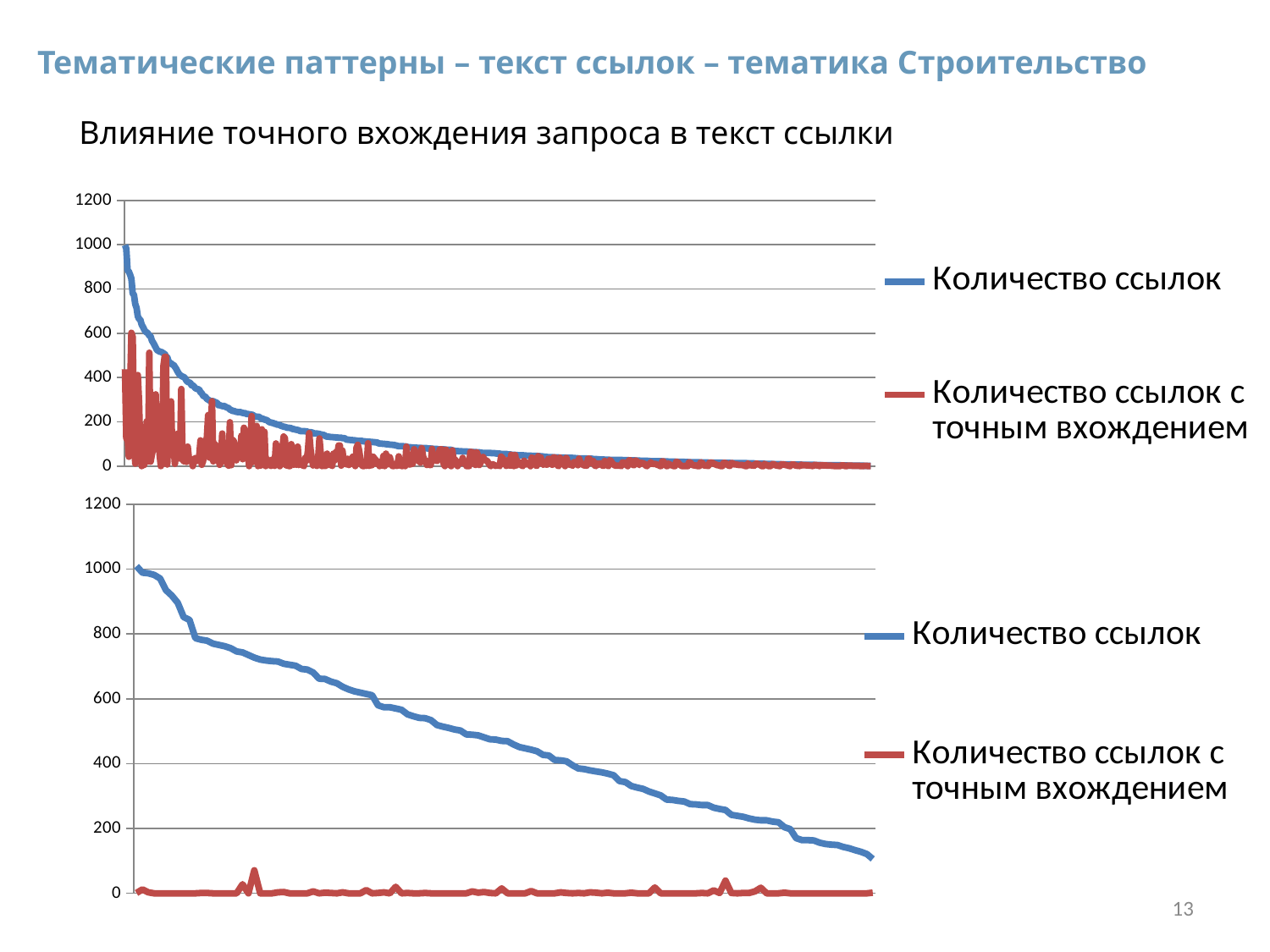
What kind of chart is the bottom chart on the slide? line chart In the bottom chart, is the first value of "Количество ссылок" greater or less than 800? greater How many series does the legend of the bottom chart list? 2 In the top chart, is the highest value of "Количество ссылок с точным вхождением" greater or less than 800? less In the bottom chart, which series has the larger values overall, "Количество ссылок" or "Количество ссылок с точным вхождением"? Количество ссылок What colour is the line for "Количество ссылок с точным вхождением" in the bottom chart? red What kind of chart is the top chart on the slide? line chart In the bottom chart, does the series "Количество ссылок" rise or fall along the x axis? fall What is the highest value shown on the y axis of the top chart? 1200 In the top chart, does the series "Количество ссылок" rise or fall along the x axis? fall How many series does the legend of the top chart list? 2 In the bottom chart, is the last value of "Количество ссылок" greater or less than 200? less